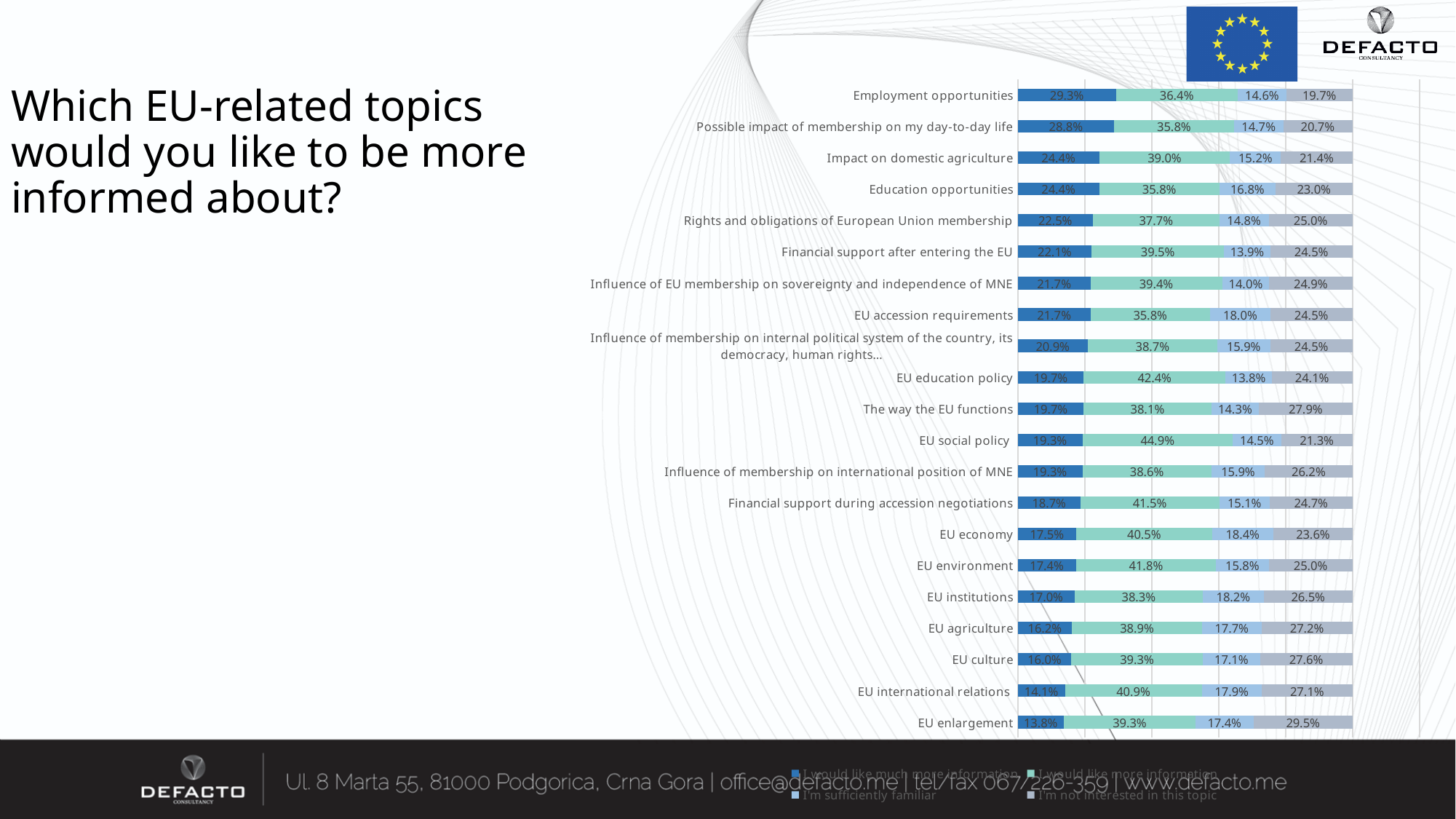
What percentage of respondents are sufficiently familiar with EU accession requirements? 18.0% Which topic has the lowest share of respondents who would like much more information? EU enlargement How many series does the chart legend list? 4 What type of chart is shown on the slide? Stacked bar chart Which has a larger 'not interested in this topic' share: The way the EU functions or EU social policy? The way the EU functions What percentage of respondents would like more information about EU social policy? 44.9% What is the difference between the 'much more information' share for Employment opportunities and for EU enlargement? 15.5 percentage points Which topic has the highest share of respondents who would like much more information? Employment opportunities What percentage of respondents would like much more information about Employment opportunities? 29.3% What percentage of respondents are not interested in the topic EU enlargement? 29.5% How many topics (categories) are listed in the chart? 21 Which topic has the highest share of respondents who would like more information (the second segment)? EU social policy